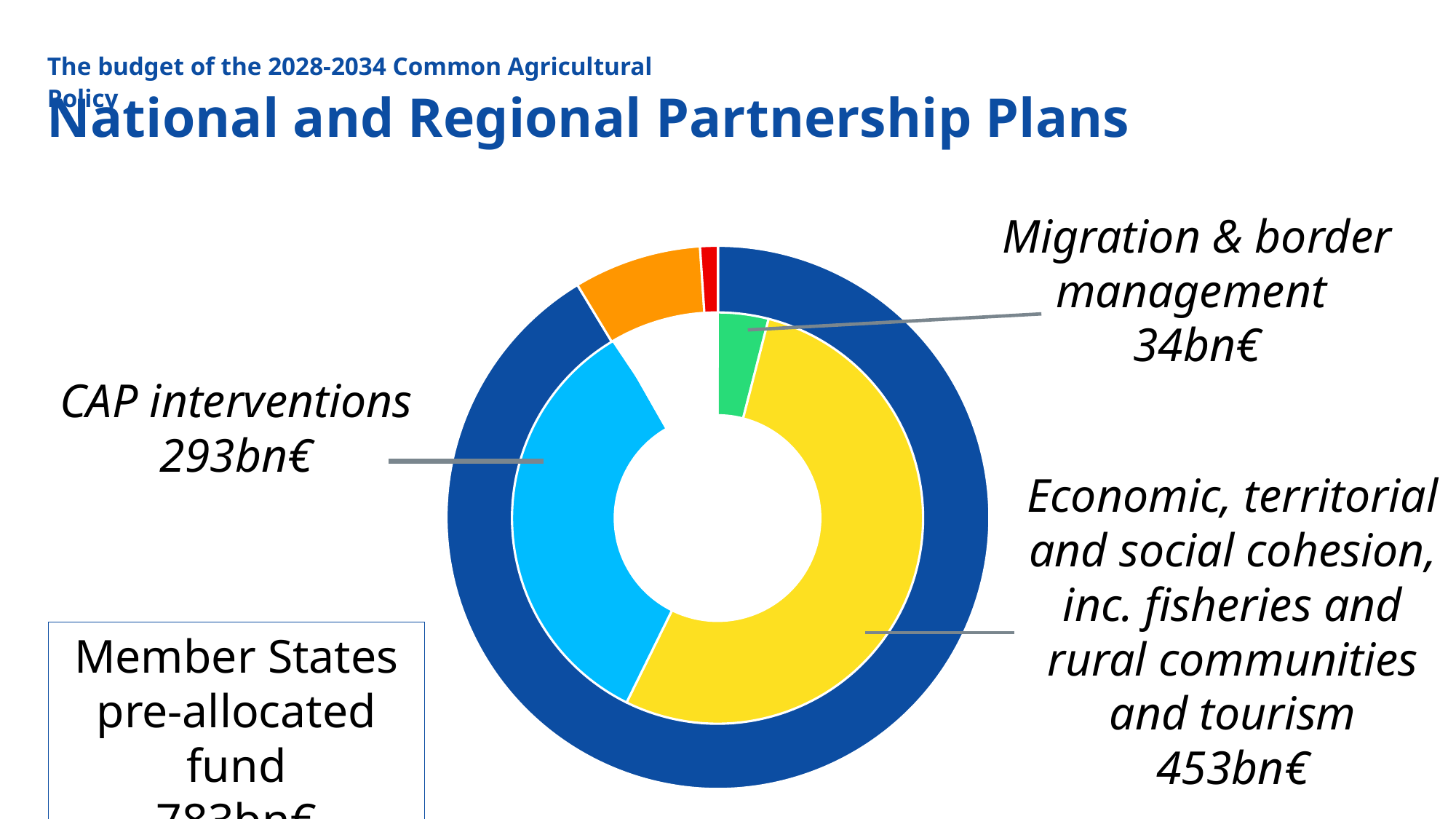
Which labelled segment has the largest value? Economic, territorial and social cohesion, inc. fisheries and rural communities and tourism Which labelled segment has the smallest value? Migration & border management Which is larger, CAP interventions or Migration & border management? CAP interventions What kind of chart is shown on the slide? Doughnut chart How many segments of the inner ring have a labelled value? 3 What colour is the CAP interventions segment? Light blue What is the difference between the CAP interventions value and the Migration & border management value? 259bn€ What is the value shown for Economic, territorial and social cohesion, inc. fisheries and rural communities and tourism? 453bn€ What is the value shown for CAP interventions? 293bn€ Which is larger, CAP interventions or Economic, territorial and social cohesion? Economic, territorial and social cohesion What is the difference between the Economic, territorial and social cohesion value and the CAP interventions value? 160bn€ What is the value shown for Migration & border management? 34bn€